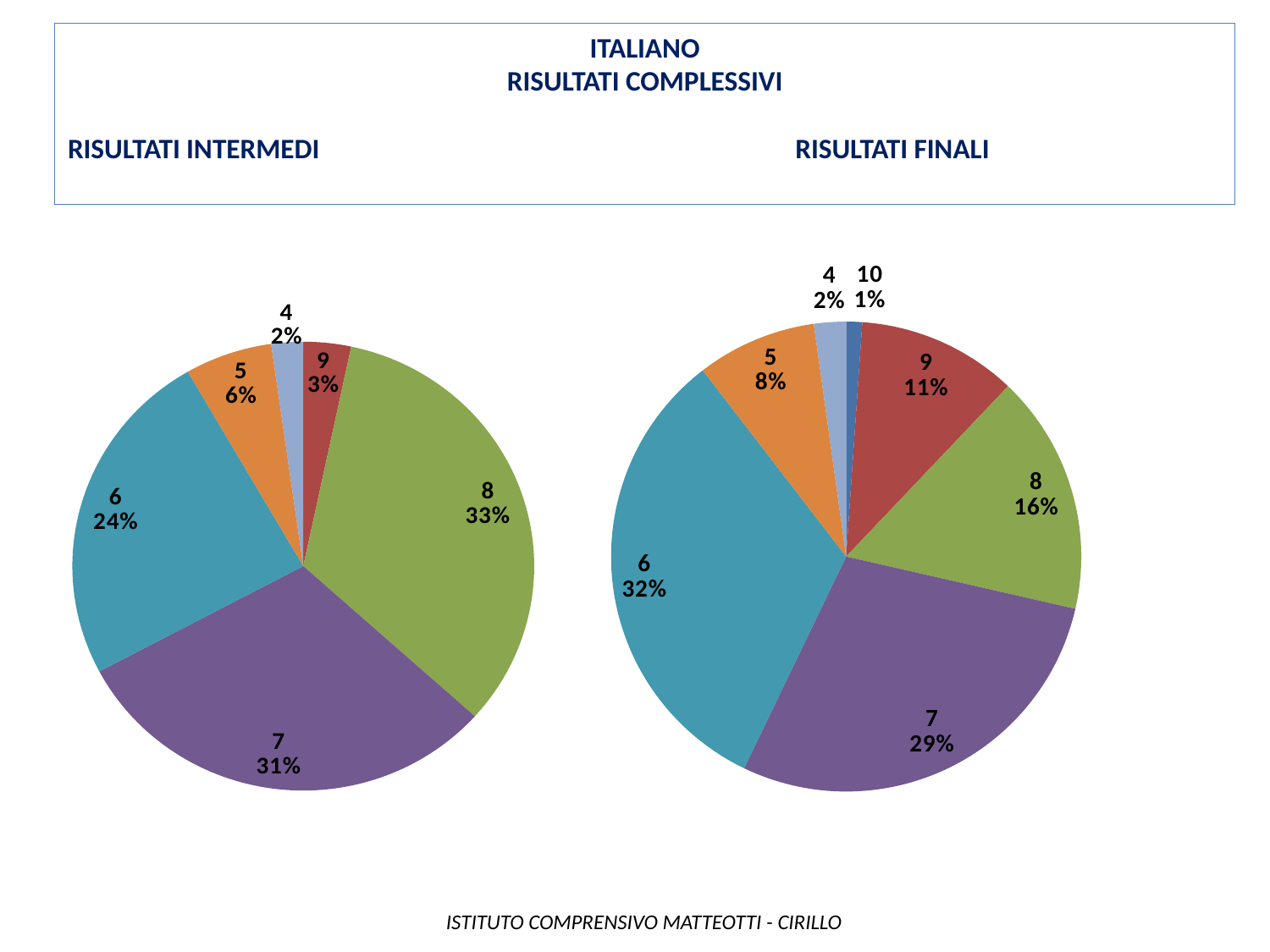
In the RISULTATI FINALI pie chart, which grade has the smallest share? 10 In the RISULTATI INTERMEDI pie chart, which grade has the smallest share? 4 In the RISULTATI FINALI pie chart, what share does grade 6 have? 32% In the RISULTATI FINALI pie chart, what is the difference between the shares of grade 6 and grade 7? 3% In the RISULTATI FINALI pie chart, which has the larger share, grade 8 or grade 9? 8 In the RISULTATI INTERMEDI pie chart, what share does grade 6 have? 24% What type of chart is used for the RISULTATI INTERMEDI results? Pie chart In the RISULTATI FINALI pie chart, what share does grade 9 have? 11% In the RISULTATI FINALI pie chart, how many slices are there? 7 In the RISULTATI INTERMEDI pie chart, which grade has the largest share? 8 In the RISULTATI INTERMEDI pie chart, how many slices are there? 6